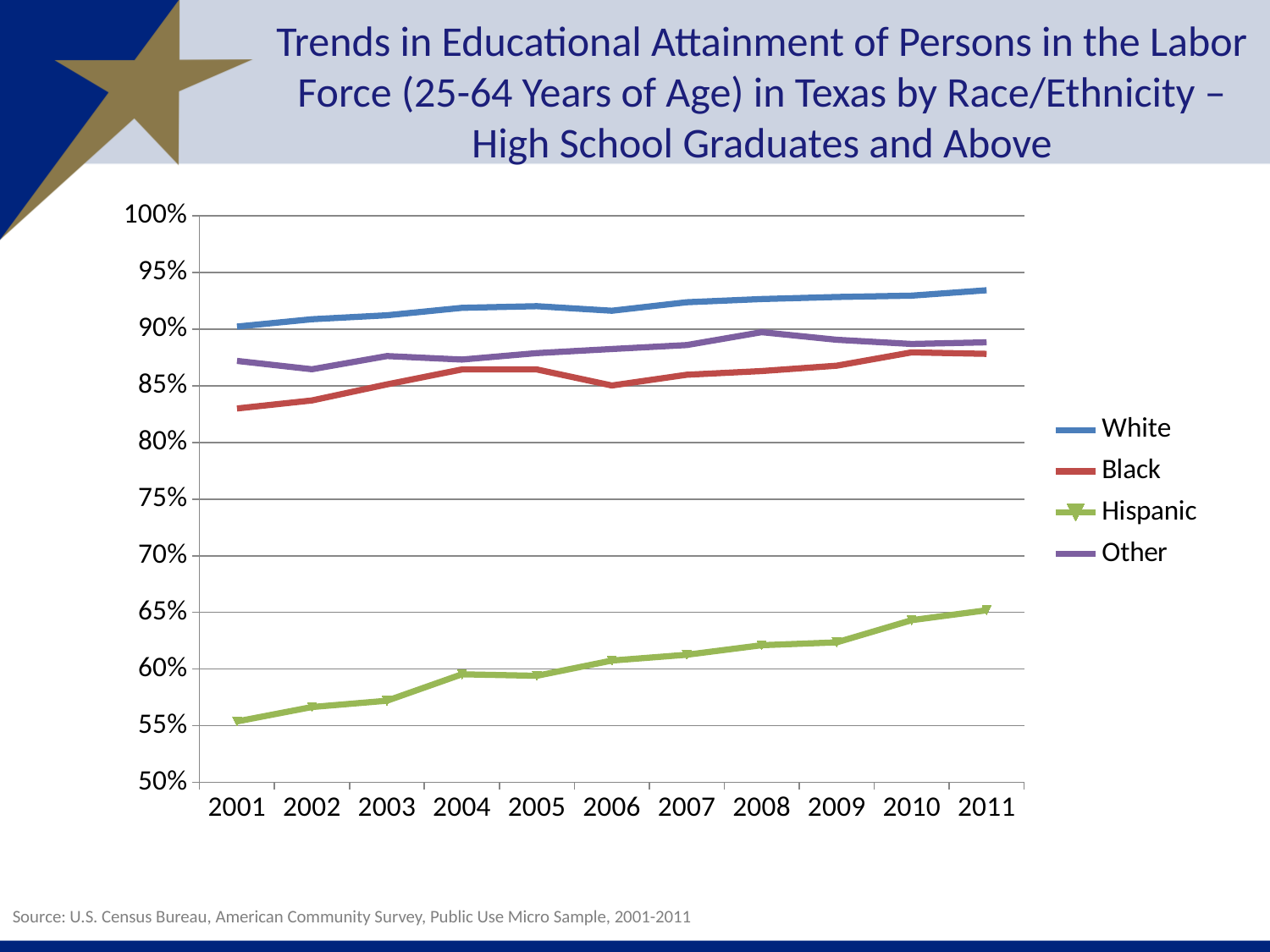
In 2008, which is higher: the value for Other or the value for Black? Other Does the Hispanic line rise or fall from 2001 to 2011? rises Which series has the highest value in 2011? White Which series has the lowest value in 2011? Hispanic Is the value for Black in 2001 greater or less than 85%? less How many series does the legend list? 4 What are the four entries listed in the legend? White, Black, Hispanic, Other How many years are shown along the x axis? 11 Is the value for Hispanic in 2011 greater or less than 60%? greater Is the value for Hispanic in 2001 greater or less than 60%? less What kind of chart is shown on the slide? line chart